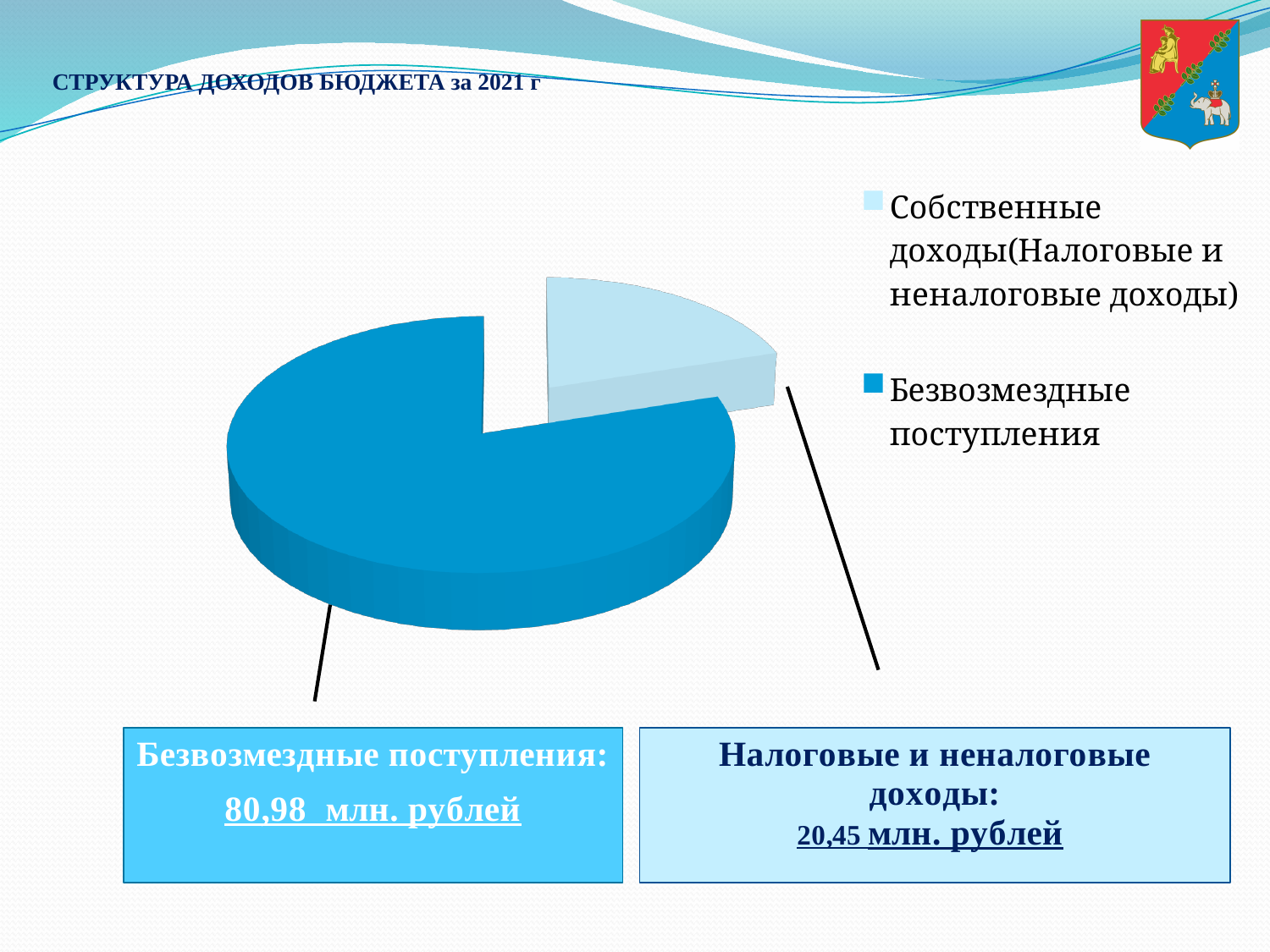
Which category has the largest slice of the pie? Безвозмездные поступления What is the value for Налоговые и неналоговые доходы? 20,45 млн. рублей Which is larger: Безвозмездные поступления or Налоговые и неналоговые доходы? Безвозмездные поступления Which legend entry is shown in the light blue colour? Собственные доходы (Налоговые и неналоговые доходы) How many slices does the pie chart have? 2 What is the difference between Безвозмездные поступления and Налоговые и неналоговые доходы? 60,53 млн. рублей What is the value for Безвозмездные поступления? 80,98 млн. рублей What is the title of the slide containing the chart? СТРУКТУРА ДОХОДОВ БЮДЖЕТА за 2021 г What is the total of the two values shown for the pie chart? 101,43 млн. рублей Which category has the smallest slice of the pie? Собственные доходы (Налоговые и неналоговые доходы) What kind of chart is shown on the slide? pie chart How many entries does the chart legend list? 2